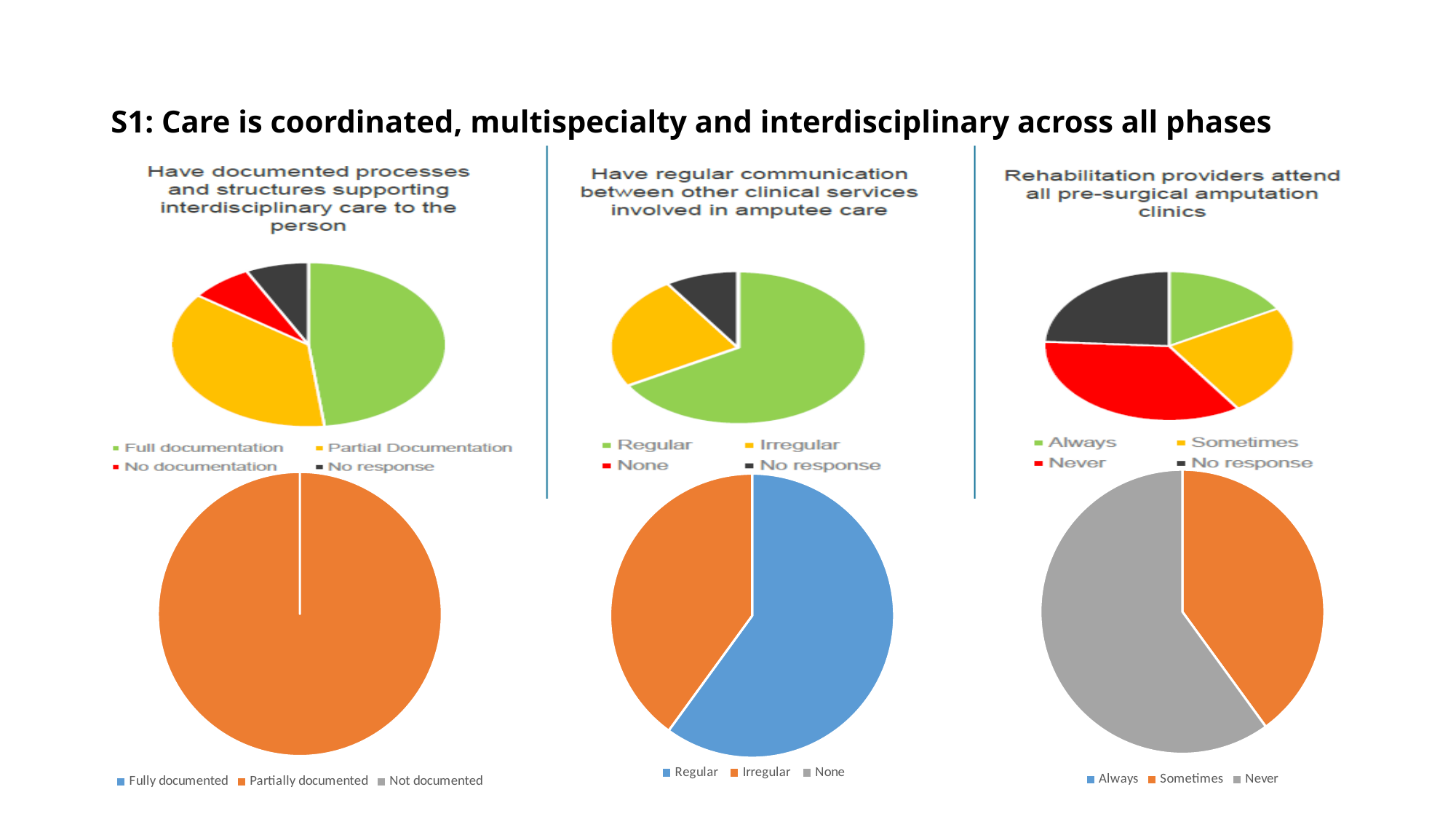
In the bottom-left pie chart, which category makes up the whole pie? Partially documented In the top-right chart titled 'Rehabilitation providers attend all pre-surgical amputation clinics', which category has the smallest slice? Always In the top-right chart titled 'Rehabilitation providers attend all pre-surgical amputation clinics', which is larger: Never or Sometimes? Never In the top-right chart titled 'Rehabilitation providers attend all pre-surgical amputation clinics', which category has the largest slice? Never In the bottom-middle pie chart, which is larger: Regular or Irregular? Regular What type of charts are shown on the slide? Pie charts How many entries does the legend of the top-left chart titled 'Have documented processes and structures supporting interdisciplinary care to the person' list? 4 How many entries does the legend of the bottom-right pie chart list? 3 How many pie charts are on the slide? 6 In the bottom-right pie chart, which category has the largest slice? Never